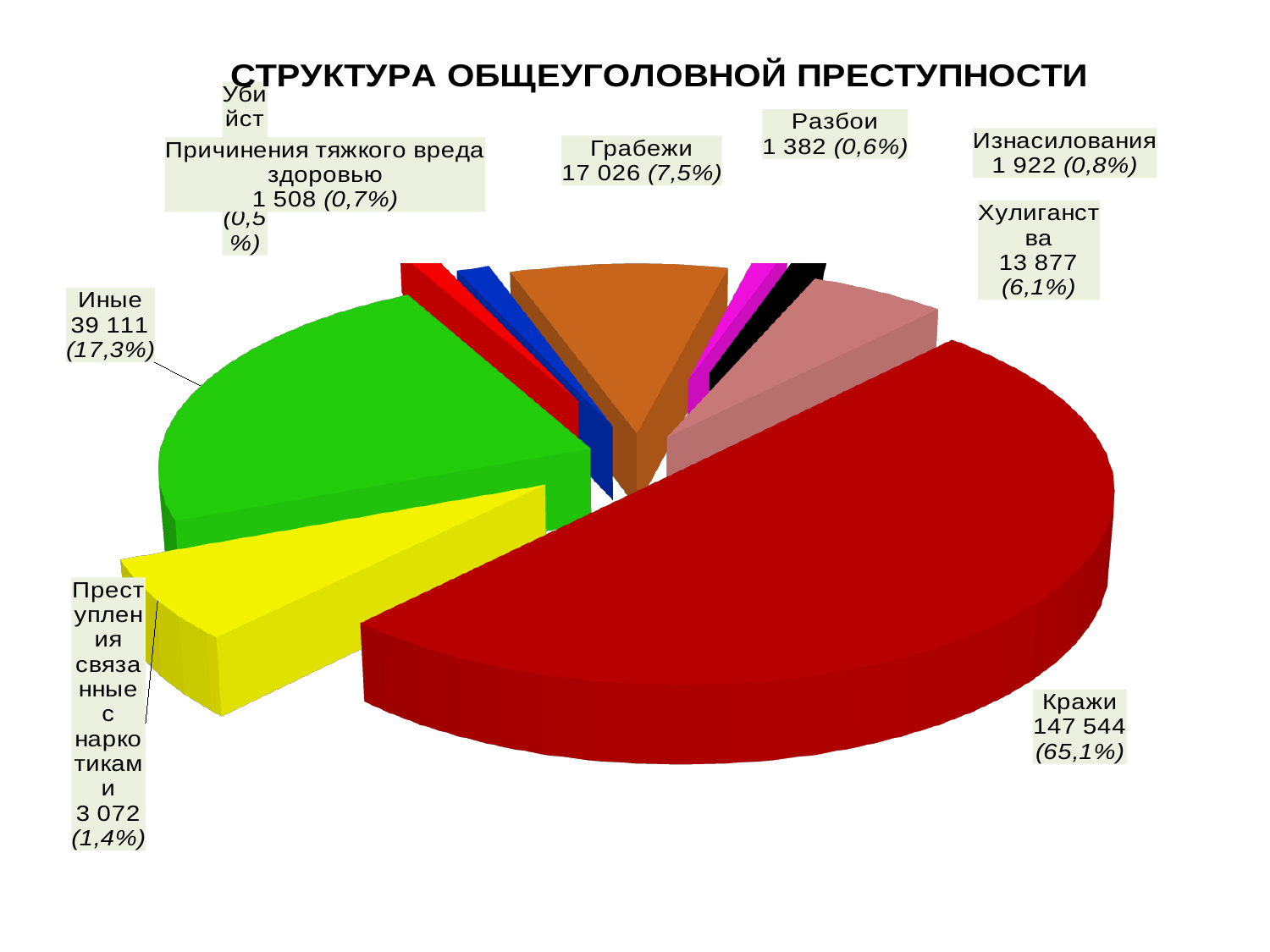
What is the title of the chart? СТРУКТУРА ОБЩЕУГОЛОВНОЙ ПРЕСТУПНОСТИ What share of the pie does Кражи represent? 65,1% What is the value shown for Преступления связанные с наркотиками? 3 072 Which category has the largest slice of the pie? Кражи What is the value shown for Иные? 39 111 What is the value shown for Хулиганства? 13 877 What kind of chart is shown on the slide? pie chart Which is larger, the value for Грабежи or the value for Хулиганства? Грабежи What share of the pie does Иные represent? 17,3% What is the value shown for Кражи? 147 544 What is the value shown for Грабежи? 17 026 What is the difference between the values for Кражи and Иные? 108 433